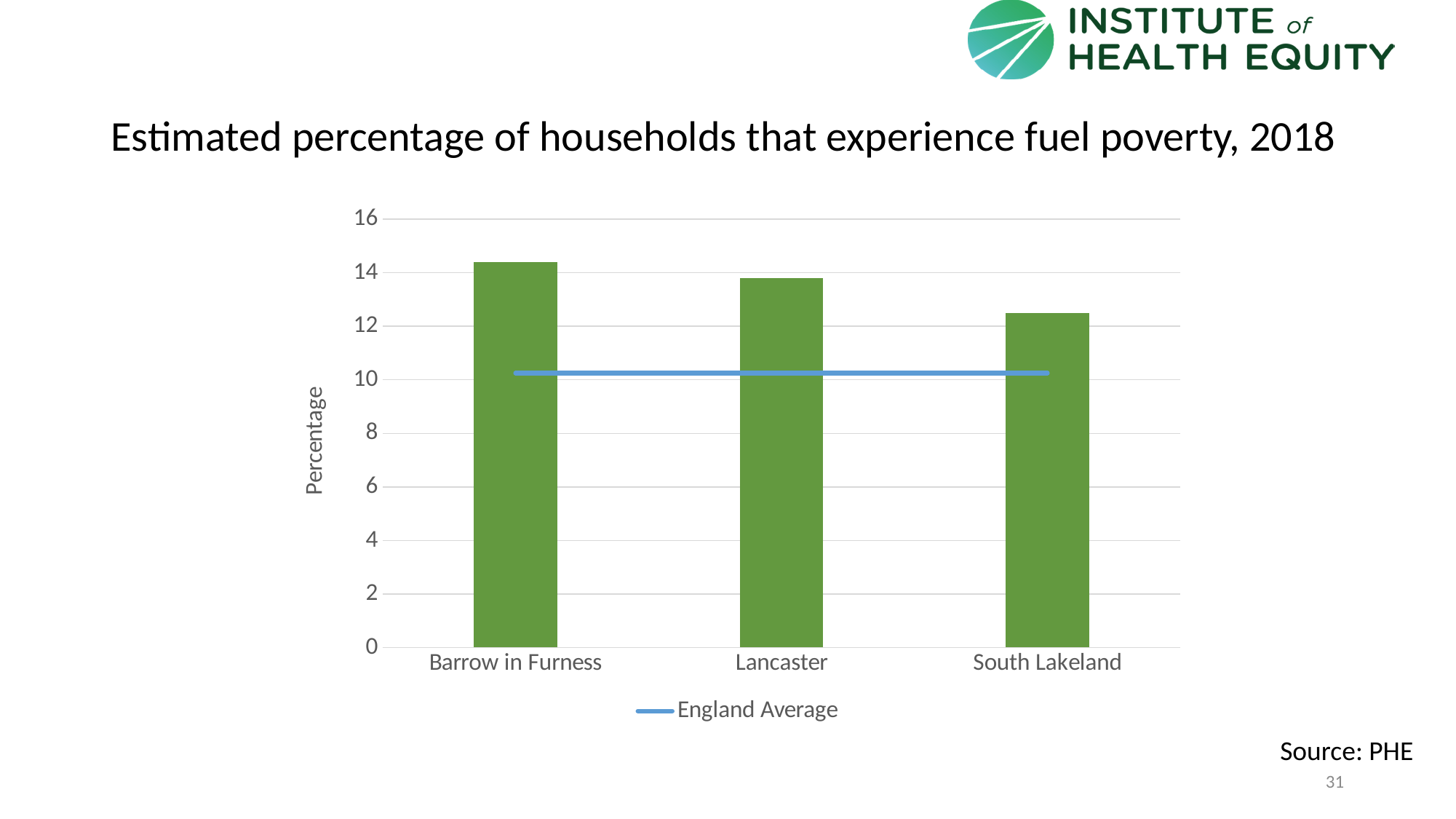
What is the label on the vertical axis of the chart? Percentage Do the bar values rise or fall moving from left to right along the x axis? fall Is the value for South Lakeland greater or less than 12? greater Which area has the lowest estimated percentage of households in fuel poverty? South Lakeland Is the value for Lancaster greater or less than 14? less What kind of chart is shown on the slide? bar chart Which area has the highest estimated percentage of households in fuel poverty? Barrow in Furness Is the value for Barrow in Furness greater or less than 14? greater How many entries does the chart legend list? 1 Which is larger, the value for Lancaster or the value for South Lakeland? Lancaster How many local areas are shown on the x axis of the chart? 3